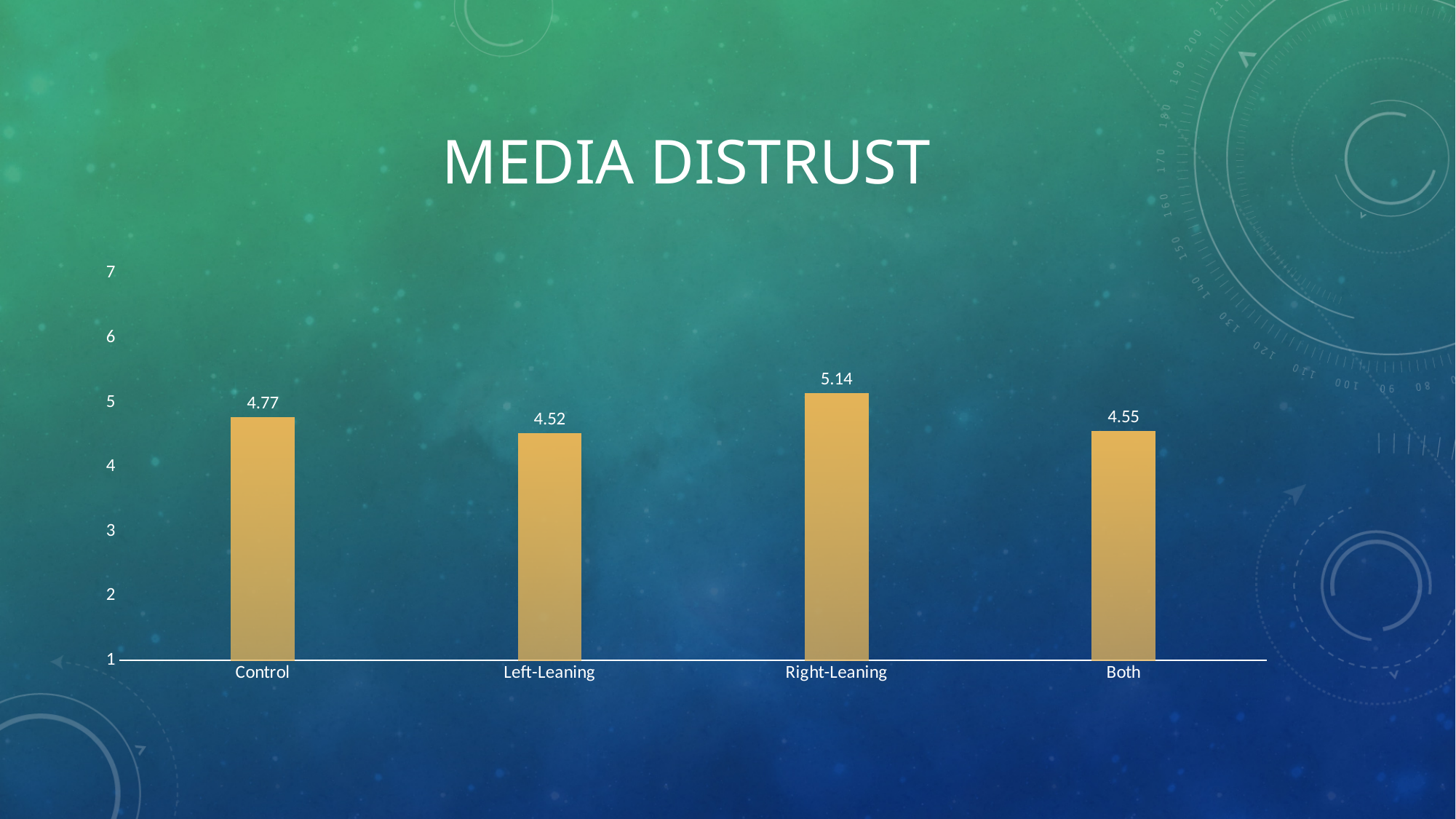
What is the value for Right-Leaning? 5.14 Which is larger, the value for Control or the value for Both? Control What is the value for Left-Leaning? 4.52 What is the difference between the values for Control and Both? 0.22 What kind of chart is shown on the slide? Bar chart What is the value for Control? 4.77 What is the difference between the values for Right-Leaning and Left-Leaning? 0.62 How many categories are shown on the x axis? 4 Which category has the highest value? Right-Leaning Is the value for Right-Leaning greater or less than 5? greater What is the value for Both? 4.55 Which category has the lowest value? Left-Leaning